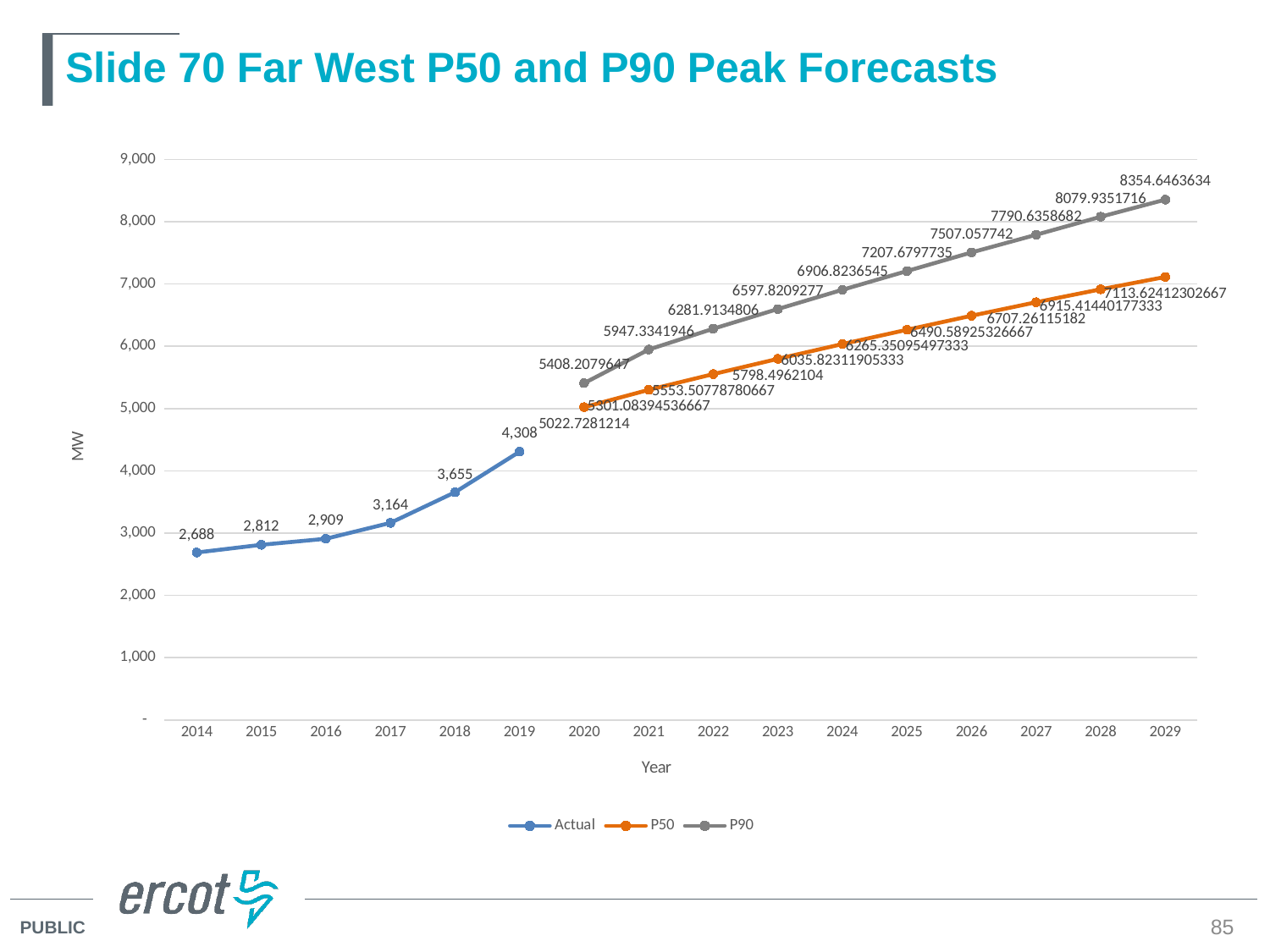
What is the Actual value for 2014? 2,688 Is the P50 value for 2025 greater or less than 6,000? greater What is the difference between the Actual values for 2019 and 2014? 1,620 What type of chart is shown on the slide? Line chart What is the P90 value for 2029? 8354.6463634 How many series does the legend list? 3 Which series has the higher value in 2029, P50 or P90? P90 Do the P90 values rise or fall from 2020 to 2029? Rise What is the P50 value for 2029? 7113.62412302667 What is the P90 value for 2020? 5408.2079647 What is the Actual value for 2019? 4,308 How many years are shown on the x axis? 16